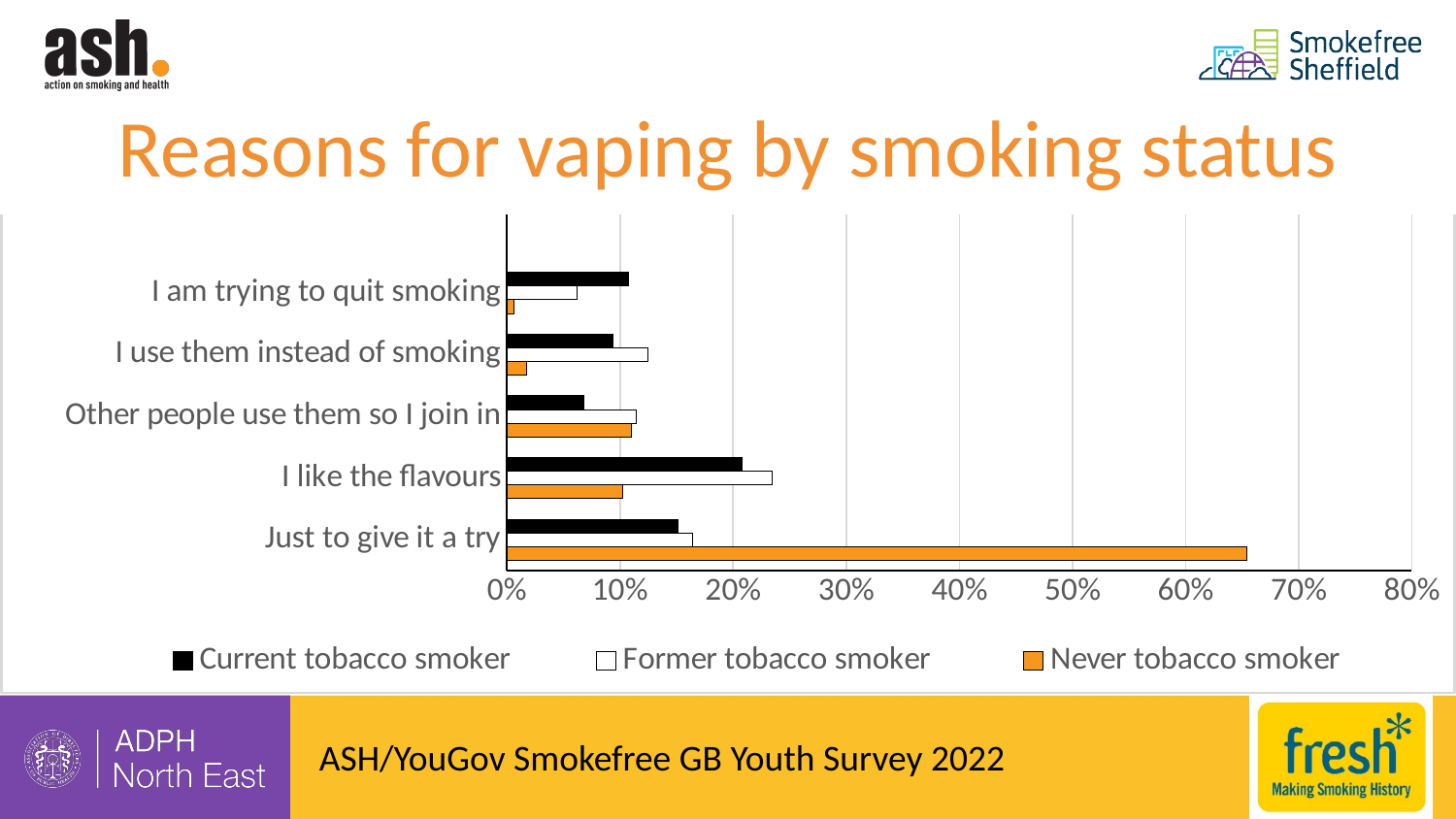
How many reasons for vaping (categories) are listed on the chart? 5 What kind of chart is shown on the slide? Bar chart Is the value for Former tobacco smokers for 'I like the flavours' greater or less than 20%? greater Is the value for Never tobacco smokers for 'I am trying to quit smoking' greater or less than 10%? less For Never tobacco smokers, which reason has the highest value? Just to give it a try How many series does the legend list? 3 For 'Just to give it a try', which is larger: the value for Never tobacco smokers or Current tobacco smokers? Never tobacco smoker For Current tobacco smokers, which reason has the highest value? I like the flavours For Never tobacco smokers, which reason has the lowest value? I am trying to quit smoking What colour represents Never tobacco smokers in the chart? Orange Is the value for Never tobacco smokers for 'Just to give it a try' greater or less than 60%? greater For 'I am trying to quit smoking', which is larger: the value for Current tobacco smokers or Never tobacco smokers? Current tobacco smoker